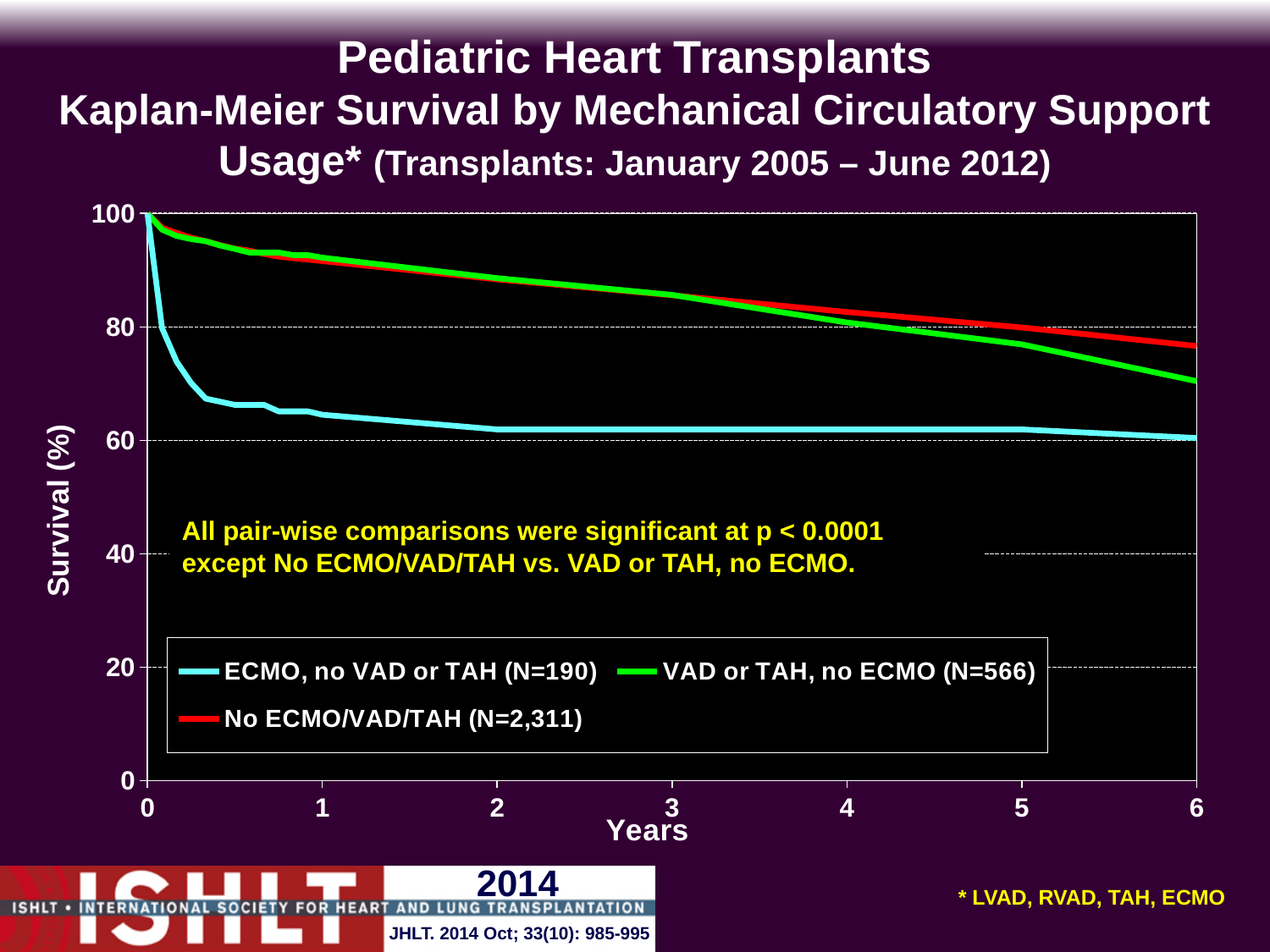
Which series has the lowest survival at 6 years? ECMO, no VAD or TAH (N=190) Is the survival for VAD or TAH, no ECMO at 1 year greater or less than 80? greater Is the survival for ECMO, no VAD or TAH at 2 years greater or less than 80? less Is the survival for ECMO, no VAD or TAH at 6 years greater or less than 80? less How many series does the legend list? 3 What is the label of the y axis? Survival (%) What is the label of the x axis? Years Which series has the highest survival at 6 years? No ECMO/VAD/TAH (N=2,311) What kind of chart is shown on the slide? line chart Does the survival for No ECMO/VAD/TAH rise or fall as years increase? fall At 3 years, which is larger: the survival for VAD or TAH, no ECMO or the survival for ECMO, no VAD or TAH? VAD or TAH, no ECMO